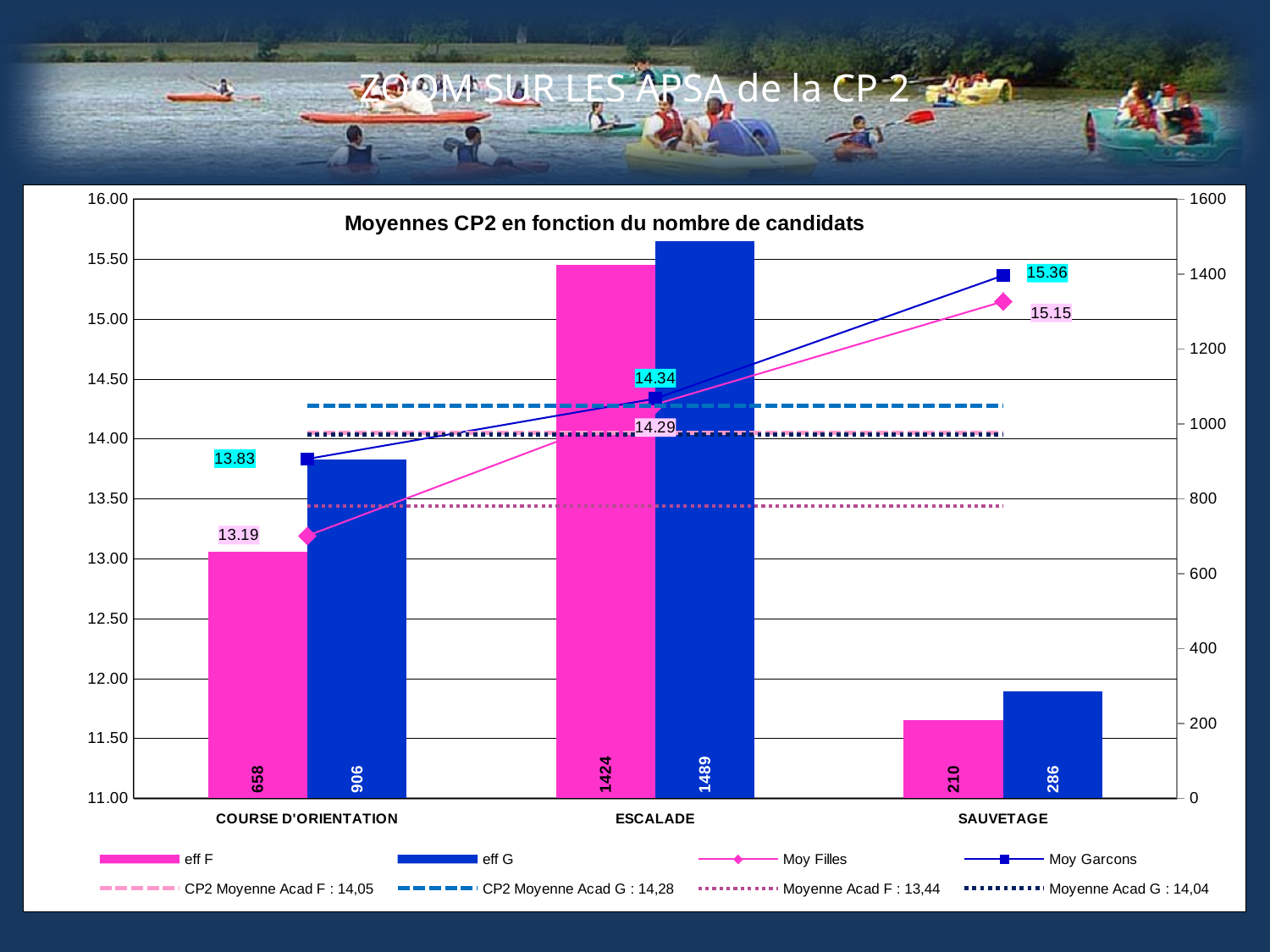
What is the value of eff G for SAUVETAGE? 286 What is the value of eff F for ESCALADE? 1424 What is the title of the chart? Moyennes CP2 en fonction du nombre de candidats Does the Moy Filles line rise or fall from COURSE D'ORIENTATION to SAUVETAGE? rise What is the difference between eff G and eff F for COURSE D'ORIENTATION? 248 How many series does the legend list? 8 What is the Moy Garcons value for COURSE D'ORIENTATION? 13.83 Which category has the highest eff G value? ESCALADE Which category has the lowest eff F value? SAUVETAGE Which is larger for ESCALADE, Moy Filles or Moy Garcons? Moy Garcons What is the Moy Filles value for SAUVETAGE? 15.15 How many categories are shown on the x axis? 3